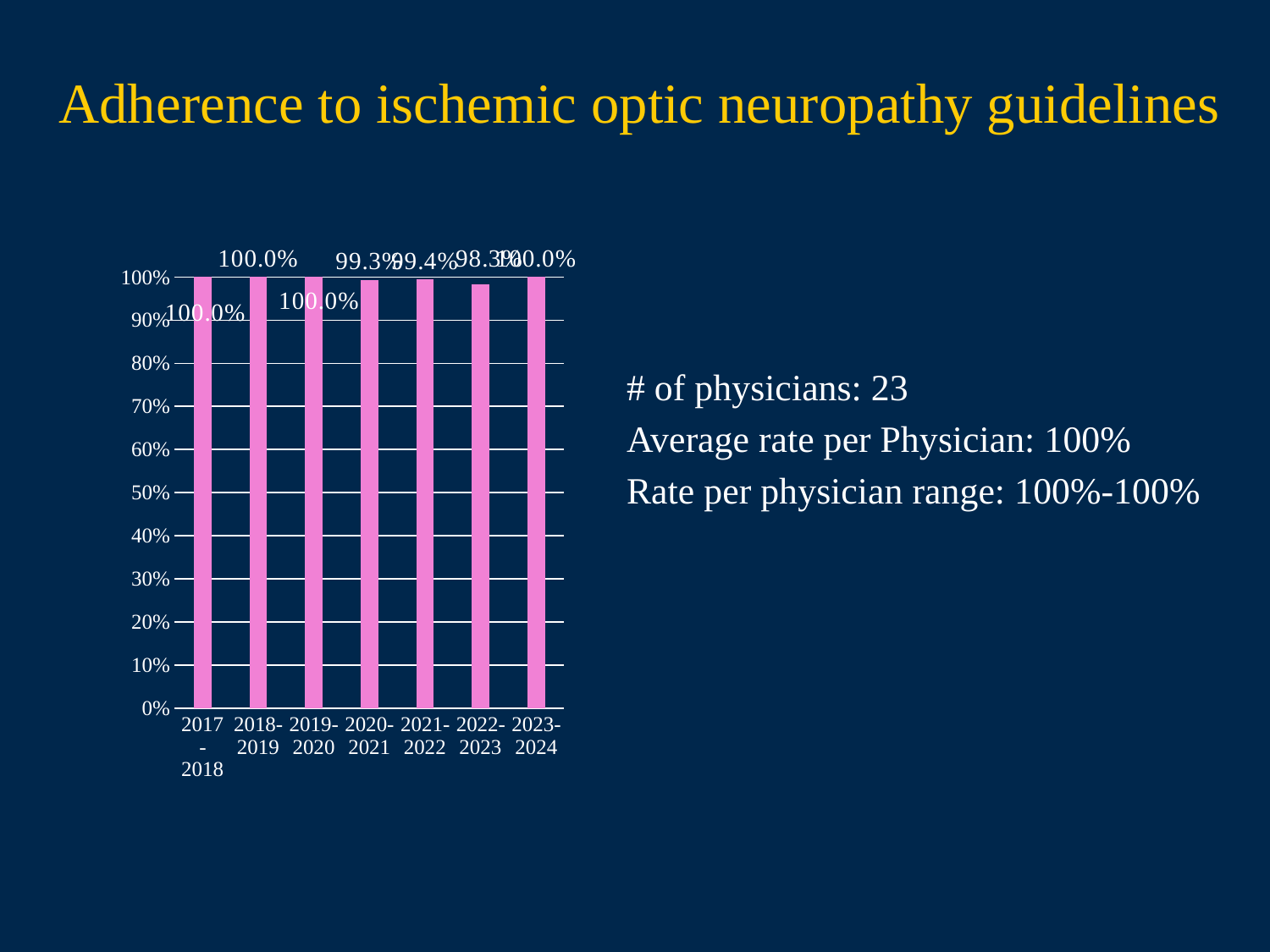
Which period has the lowest value? 2022-2023 What is the difference between the values for 2020-2021 and 2022-2023? 1.0% Is the value for 2022-2023 greater or less than 90%? greater What is the value for 2023-2024? 100.0% Which is larger, the value for 2017-2018 or the value for 2022-2023? 2017-2018 What kind of chart is shown on the slide? bar chart What is the value for 2020-2021? 99.3% What is the value for 2017-2018? 100.0% How many periods are shown on the x axis? 7 What colour are the bars in the chart? pink What is the value for 2022-2023? 98.3% What is the value for 2021-2022? 99.4%